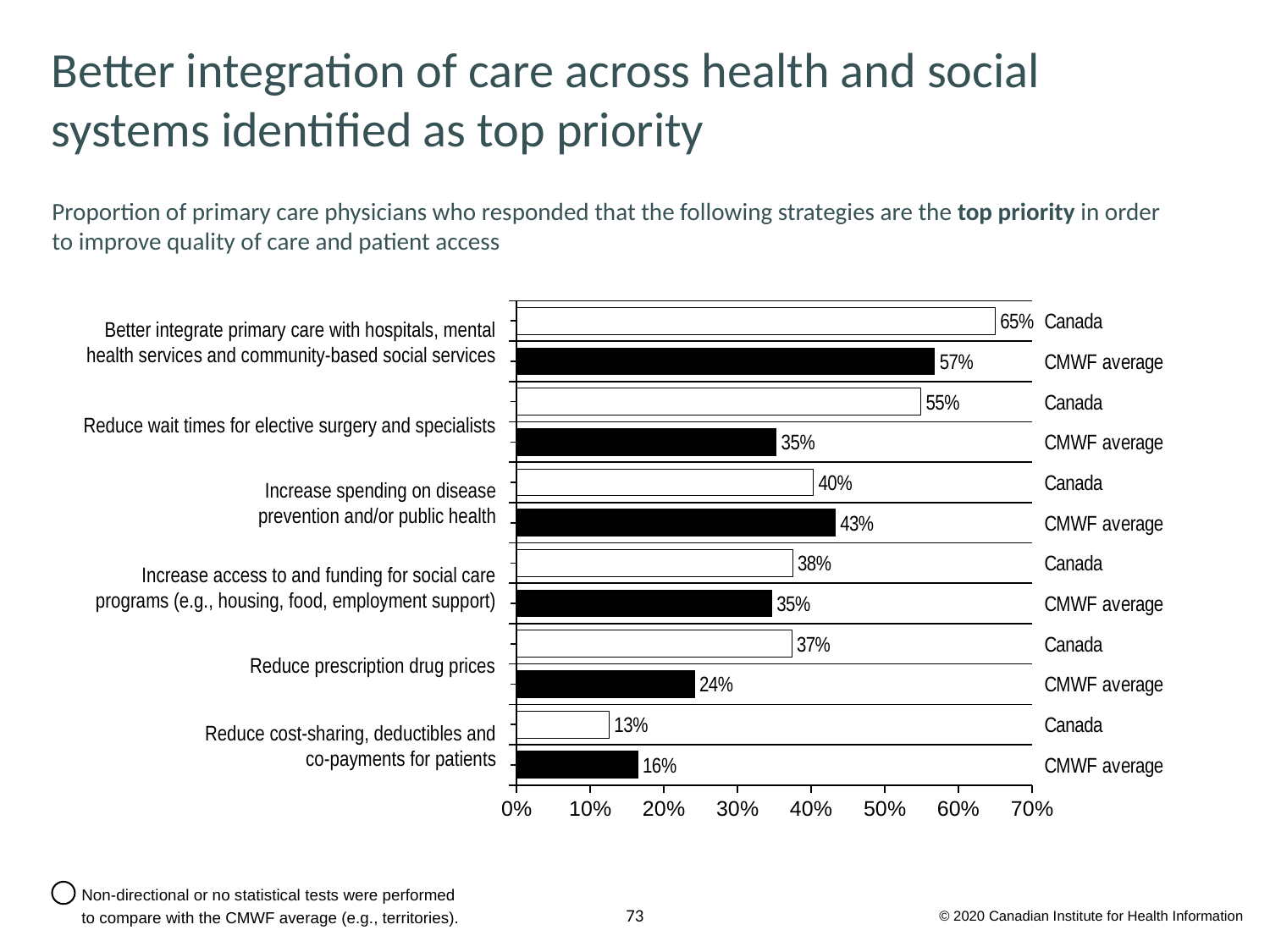
What kind of chart is shown on the slide? Bar chart For 'Increase spending on disease prevention and/or public health', which is larger: the Canada value or the CMWF average? CMWF average How many strategies are shown on the chart? 6 What is the difference between the Canada and CMWF average values for 'Reduce wait times for elective surgery and specialists'? 20% Is the Canada value for 'Reduce cost-sharing, deductibles and co-payments for patients' greater or less than 20%? less What is the CMWF average value for 'Reduce wait times for elective surgery and specialists'? 35% What is the Canada value for 'Reduce prescription drug prices'? 37% Which strategy has the highest Canada value? Better integrate primary care with hospitals, mental health services and community-based social services What is the difference between the Canada and CMWF average values for 'Reduce prescription drug prices'? 13% What is the Canada value for 'Better integrate primary care with hospitals, mental health services and community-based social services'? 65% How many series does the chart show for each strategy? 2 Which strategy has the lowest CMWF average value? Reduce cost-sharing, deductibles and co-payments for patients